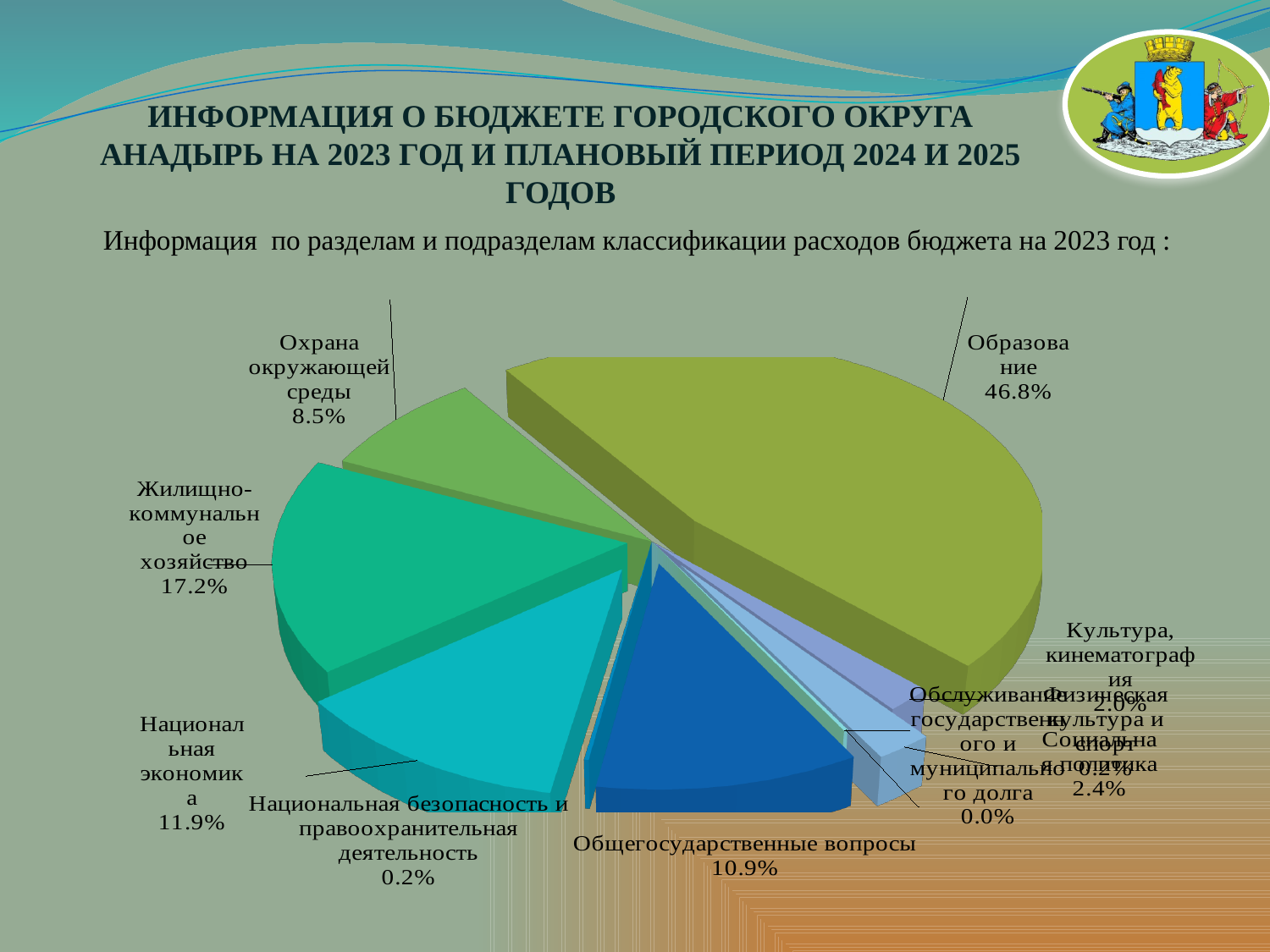
What percentage is shown for Обслуживание государственного и муниципального долга? 0.0% What percentage is shown for Охрана окружающей среды? 8.5% What percentage is shown for Национальная безопасность и правоохранительная деятельность? 0.2% What share of the 2023 budget expenditures goes to Образование? 46.8% Which has a larger share: Жилищно-коммунальное хозяйство or Национальная экономика? Жилищно-коммунальное хозяйство What kind of chart is shown on the slide? pie chart What percentage is shown for Общегосударственные вопросы? 10.9% What percentage is shown for Жилищно-коммунальное хозяйство? 17.2% Which section has the largest share of the budget expenditures? Образование By how many percentage points does the share of Образование exceed that of Жилищно-коммунальное хозяйство? 29.6% What percentage is shown for Национальная экономика? 11.9% By how many percentage points does Национальная экономика exceed Общегосударственные вопросы? 1.0%